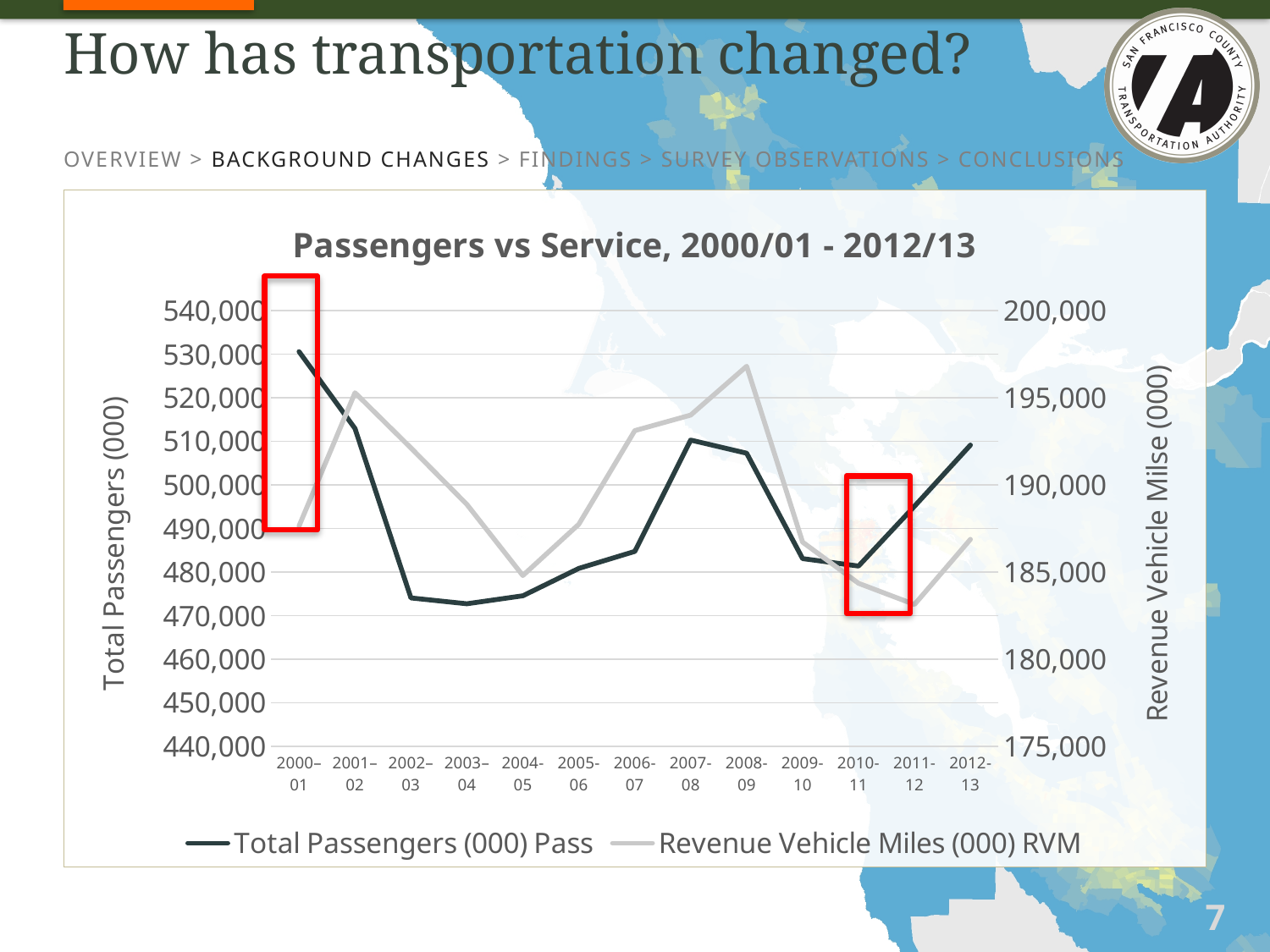
How many series does the legend list? 2 Is the Total Passengers (000) value for 2002-03 greater or less than 480,000? less Which year has more Total Passengers (000): 2007-08 or 2009-10? 2007-08 How many fiscal years are plotted along the x axis? 13 What is the title of the chart? Passengers vs Service, 2000/01 - 2012/13 Does Total Passengers (000) rise or fall from 2010-11 to 2012-13? rise Is the Revenue Vehicle Miles (000) value for 2001-02 greater or less than 190,000? greater Is the Total Passengers (000) value for 2000-01 greater or less than 520,000? greater What kind of chart is shown on the slide? line chart In which year is Total Passengers (000) highest? 2000-01 In which year is Revenue Vehicle Miles (000) highest? 2008-09